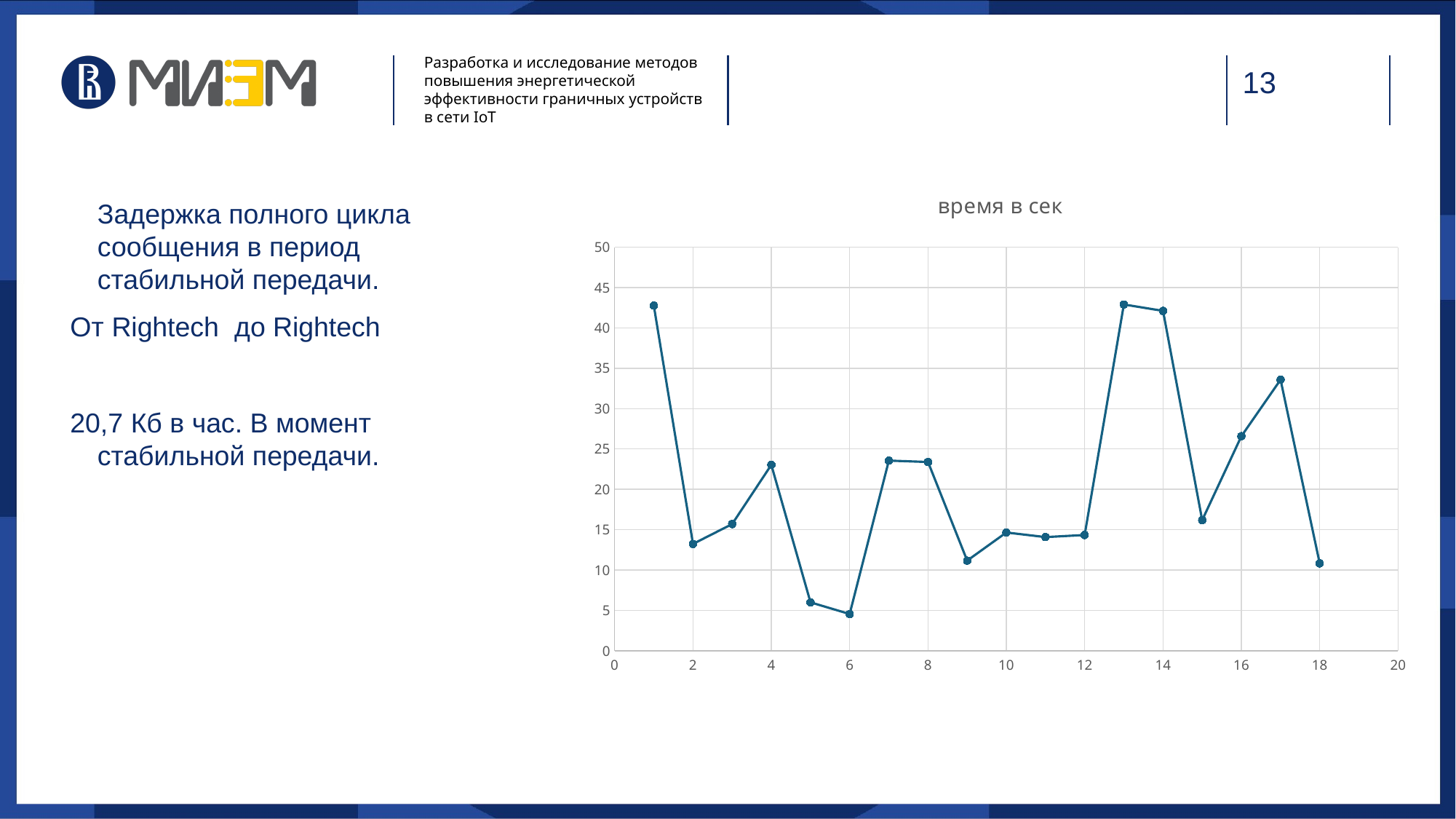
Do the values rise or fall from x = 15 to x = 17? rise At which x value is the lowest point on the chart? 6 How many data points are plotted on the chart? 18 Which has the larger value, the point at x = 13 or the point at x = 15? x = 13 What is the title of the chart? время в сек Is the value at x = 1 greater or less than 40? greater Is the value at x = 9 greater or less than 15? less Is the value at x = 4 greater or less than 20? greater What is the highest value shown on the y axis? 50 What kind of chart is shown on the slide? line chart